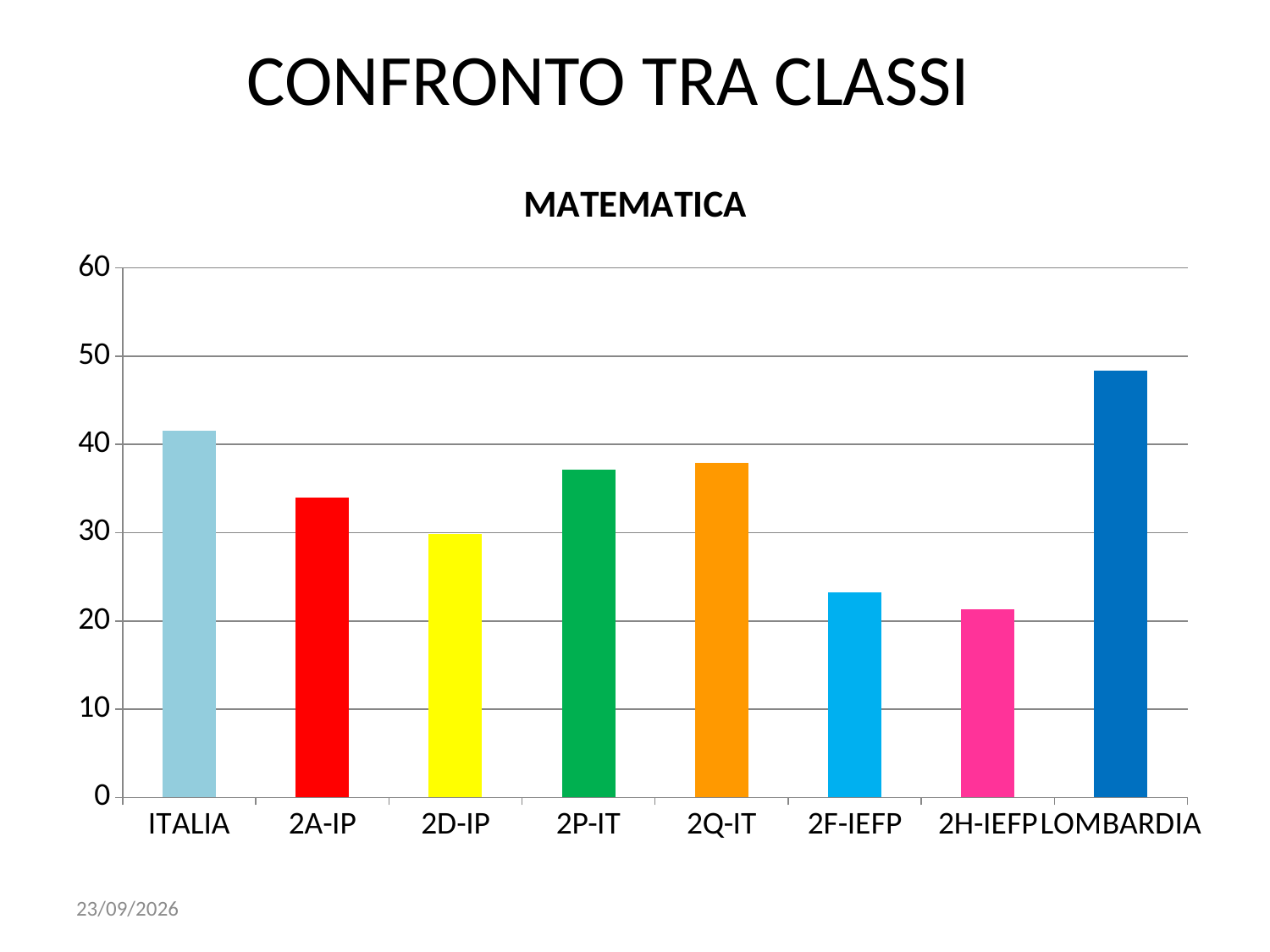
Is the value for ITALIA greater or less than 40? greater Which has the larger value, 2Q-IT or 2F-IEFP? 2Q-IT Which category has the highest value in the chart? LOMBARDIA Which has the larger value, 2A-IP or 2D-IP? 2A-IP How many categories are shown on the x axis of the chart? 8 Is the value for LOMBARDIA greater or less than 50? less Which has the larger value, ITALIA or LOMBARDIA? LOMBARDIA Which category has the lowest value in the chart? 2H-IEFP What kind of chart is shown on the slide? bar chart What is the title of the chart? MATEMATICA Is the value for 2A-IP greater or less than 30? greater